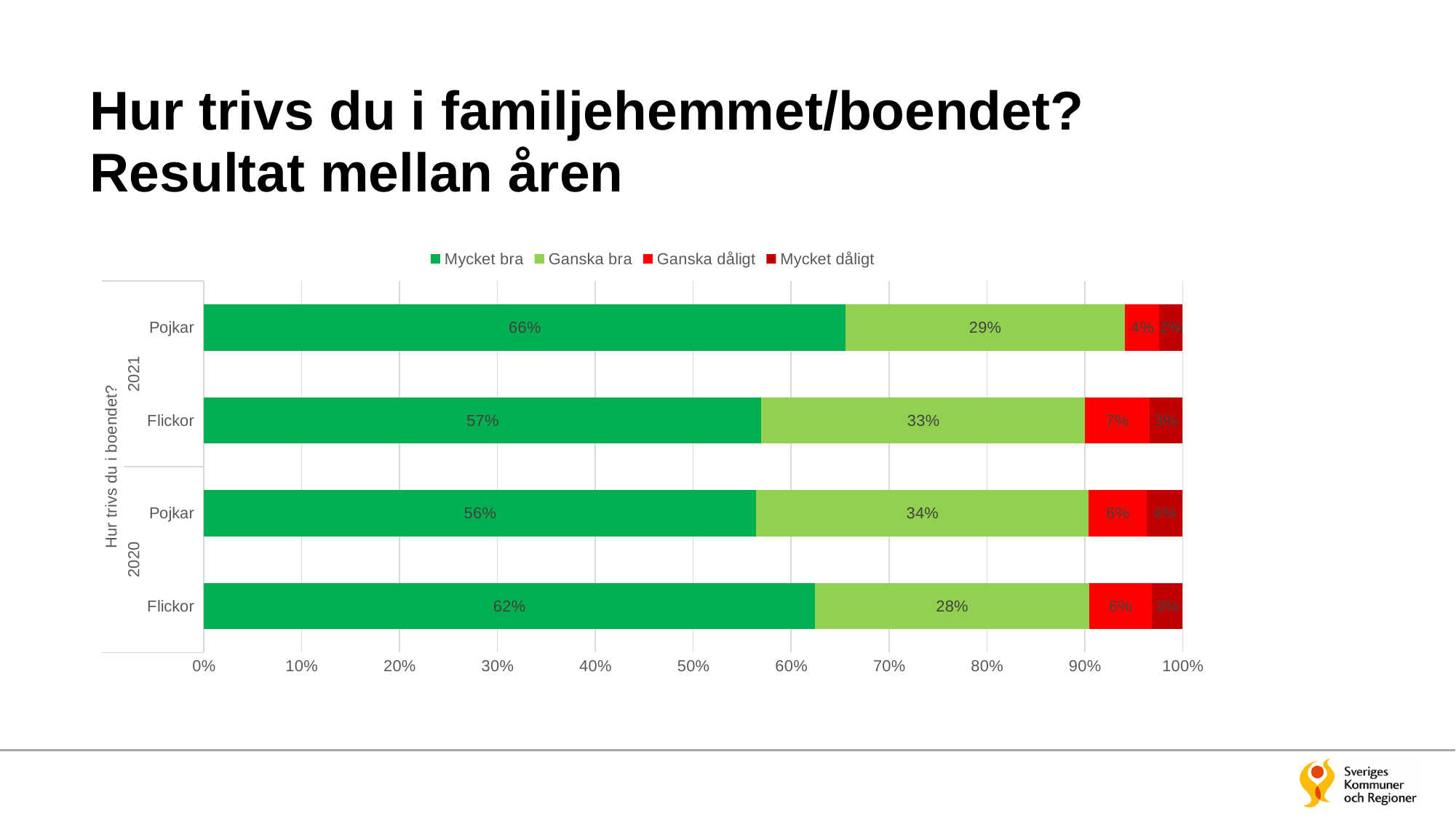
Which group has the larger "Ganska bra" share, Pojkar 2020 or Flickor 2020? Pojkar 2020 What is the difference in the "Mycket bra" share between Pojkar 2021 and Flickor 2021? 9 percentage points Which group has the highest share answering "Mycket bra"? Pojkar 2021 How many series does the legend list? 4 How many bars are shown in the chart? 4 What percentage of Flickor in 2021 answered "Ganska dåligt"? 7% Which group has the lowest share answering "Mycket bra"? Pojkar 2020 What percentage of Pojkar in 2021 answered "Mycket bra"? 66% What percentage of Flickor in 2020 answered "Mycket bra"? 62% What percentage of Pojkar in 2020 answered "Ganska bra"? 34% What type of chart is shown on the slide? Stacked bar chart What percentage of Flickor in 2021 answered "Ganska bra"? 33%